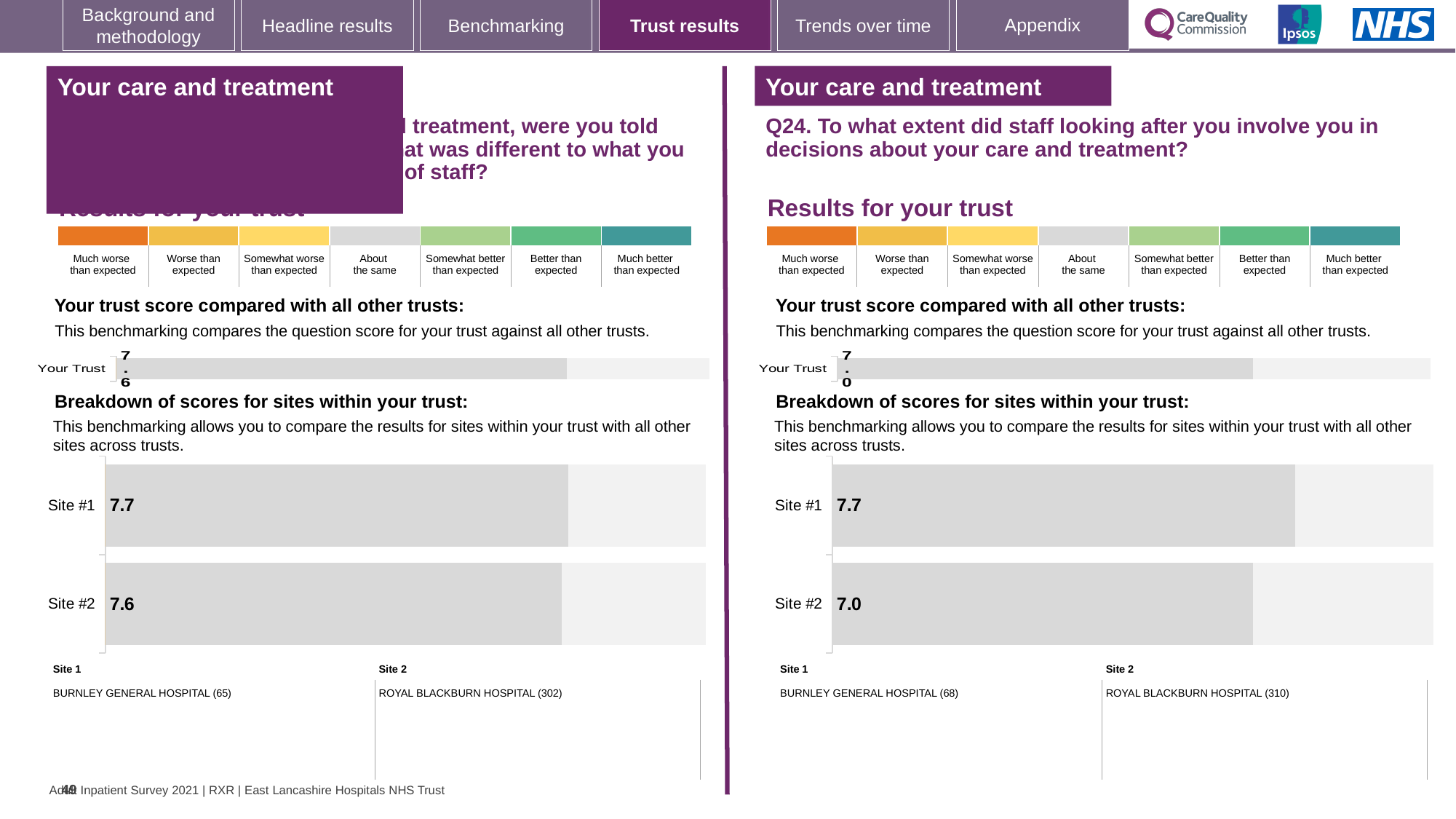
In the right-hand panel (Q24), what is the score for Site #1 in the breakdown of scores for sites within your trust? 7.7 In the right-hand panel (Q24), which site has the higher score in the site breakdown chart? Site #1 In the left-hand panel, what is the score for Site #1 in the breakdown of scores for sites within your trust? 7.7 In the left-hand panel, what is the difference between the Site #1 and Site #2 scores? 0.1 In the right-hand panel (Q24), what is the score for Site #2 in the breakdown of scores for sites within your trust? 7.0 In the right-hand panel (Q24), what is the difference between the Site #1 and Site #2 scores? 0.7 In the right-hand panel (Q24), which hospital is listed as Site 2? ROYAL BLACKBURN HOSPITAL (310) In the right-hand panel (Q24), what is the 'Your Trust' score shown in the trust comparison bar? 7.0 What type of chart is used for the breakdown of scores for sites within your trust in the right-hand panel (Q24)? Bar chart How many sites are shown in the site breakdown chart of the right-hand panel (Q24)? 2 In the left-hand panel, what is the 'Your Trust' score shown in the trust comparison bar? 7.6 In the left-hand panel, what is the score for Site #2 in the breakdown of scores for sites within your trust? 7.6